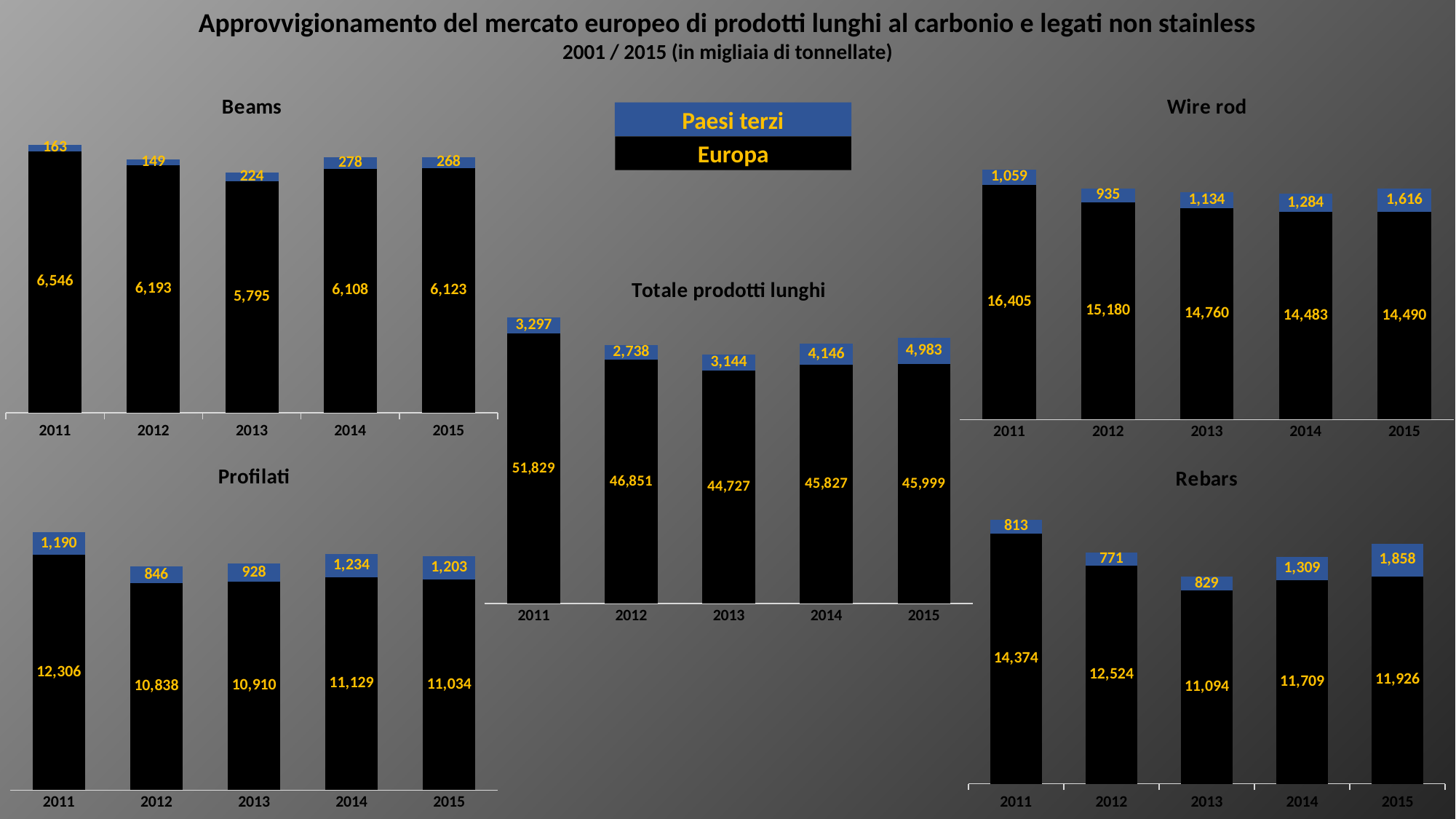
In the Wire rod chart, what is the Paesi terzi value for 2015? 1,616 In the Rebars chart, which year has the highest Paesi terzi value? 2015 How many series does the legend list? 2 In the Wire rod chart, what is the difference between the Europa values for 2011 and 2012? 1,225 How many years are shown on the x axis of the Profilati chart? 5 In the Profilati chart, which year has the lowest Europa value? 2012 In the Totale prodotti lunghi chart, what is the Europa value for 2013? 44,727 What kind of chart is the Totale prodotti lunghi chart? Stacked bar chart In the Beams chart, is the Paesi terzi value larger in 2014 or in 2015? 2014 In the Totale prodotti lunghi chart, what is the total of the stacked bar for 2011? 55,126 In the Rebars chart, what is the total of the stacked bar for 2015? 13,784 In the Beams chart, what is the Europa value for 2011? 6,546